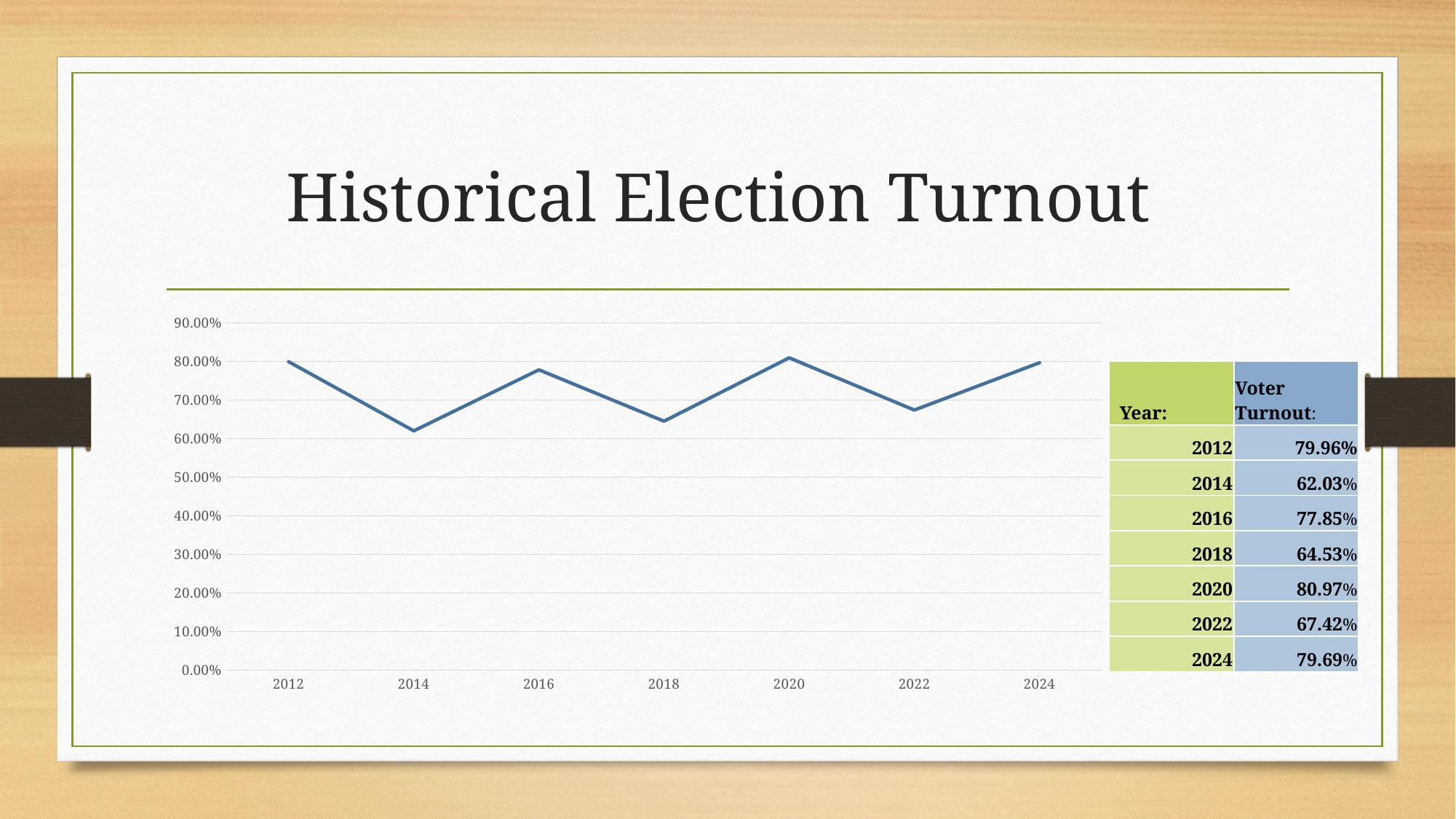
Does voter turnout rise or fall from 2012 to 2014? fall How many years are plotted on the chart? 7 Which year had the lowest voter turnout? 2014 What was the voter turnout in 2014? 62.03% What was the voter turnout in 2020? 80.97% Which year had the highest voter turnout? 2020 What was the voter turnout in 2024? 79.69% What type of chart is shown on the slide? line chart Which year had higher voter turnout, 2016 or 2018? 2016 What is the title of the chart on the slide? Historical Election Turnout Is the voter turnout for 2022 greater or less than 70.00%? less What is the difference in voter turnout between 2020 and 2014? 18.94 percentage points